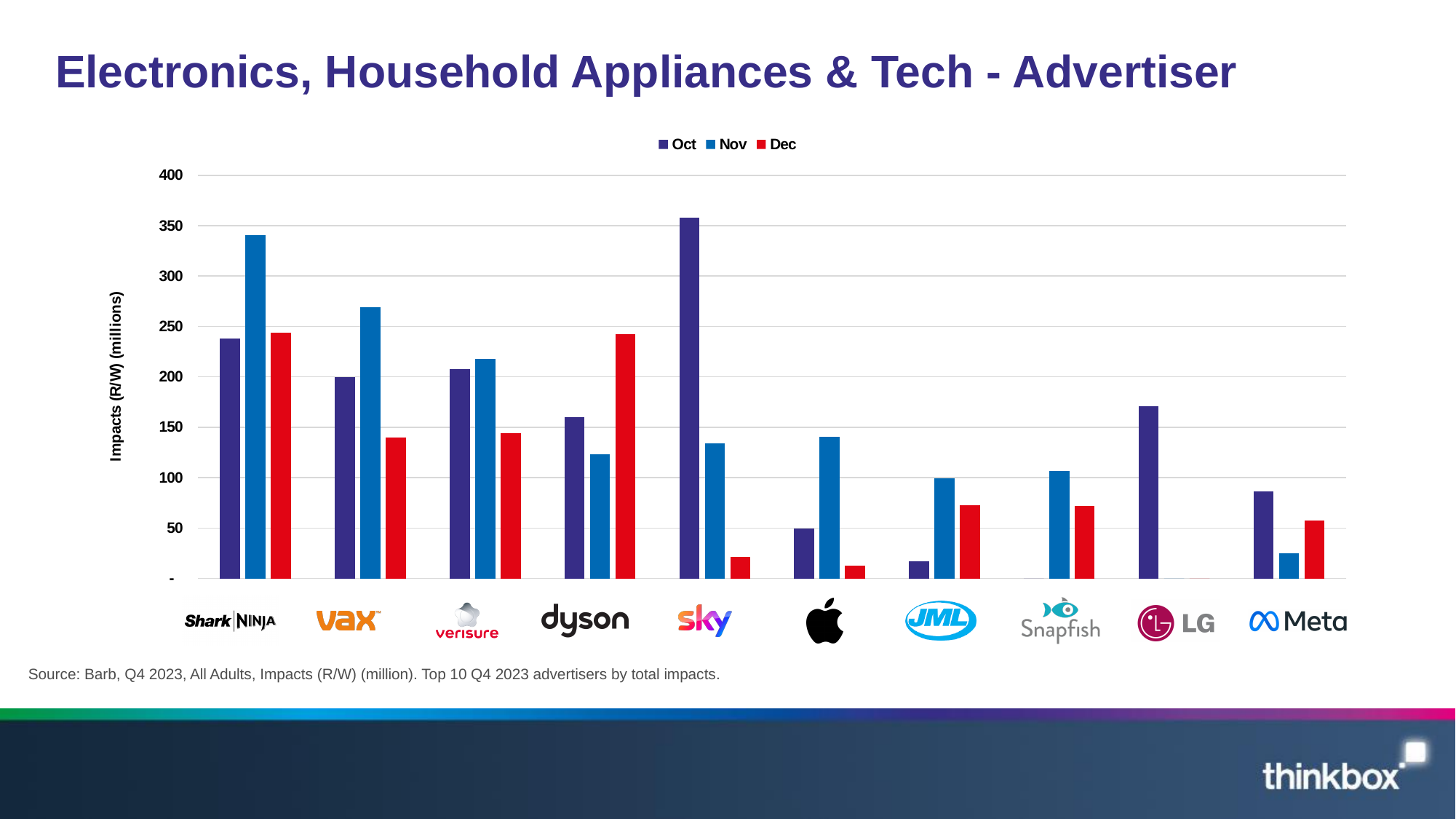
Is the Nov value for Shark Ninja greater or less than 300? greater What is the label on the y axis? Impacts (R/W) (millions) How many advertisers are shown along the x axis? 10 Which colour represents Dec in the legend? Red Is the Dec value for Vax greater or less than 150? less For Dyson, which is larger: the Nov value or the Dec value? Dec For Apple, which is larger: the Oct value or the Nov value? Nov What kind of chart is shown on the slide? Bar chart Is the Oct value for Sky greater or less than 300? greater Which advertiser has the highest Oct value? Sky How many series does the legend list? 3 Which advertiser has the highest Nov value? Shark Ninja